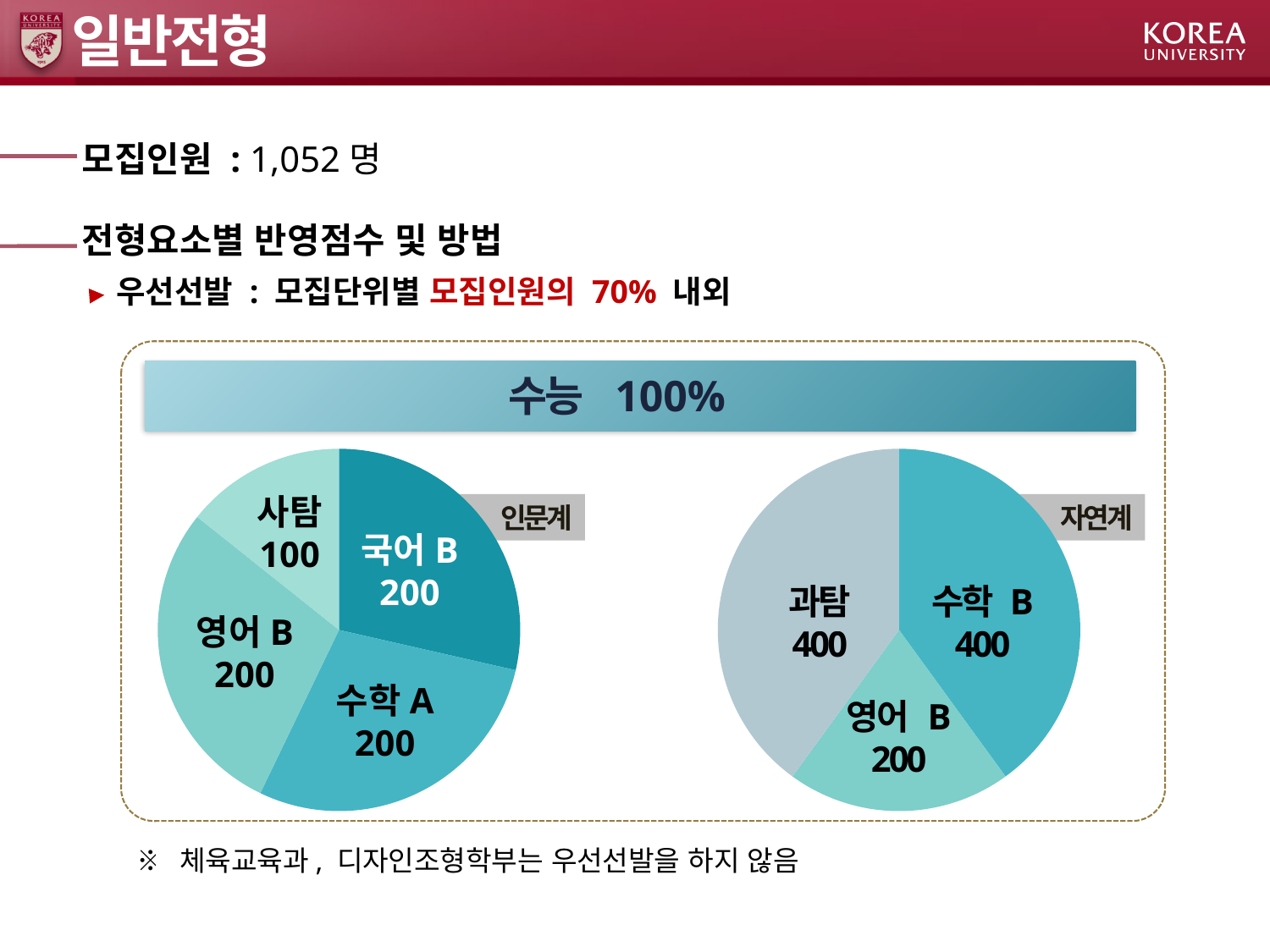
What is the text in the banner above the two pie charts? 수능 100% In the 인문계 pie chart, what is the difference between 영어 B and 사탐? 100 How many slices does the 인문계 pie chart have? 4 In the 자연계 pie chart, which is larger, 수학 B or 영어 B? 수학 B In the 인문계 pie chart, which category has the smallest value? 사탐 In the 인문계 pie chart, what is the value for 사탐? 100 In the 자연계 pie chart, what is the value for 과탐? 400 In the 자연계 pie chart, what is the value for 영어 B? 200 How many slices does the 자연계 pie chart have? 3 In the 자연계 pie chart, what share of the total does 영어 B represent? 20% What kind of chart is the 인문계 chart? pie chart In the 인문계 pie chart, what is the value for 국어 B? 200